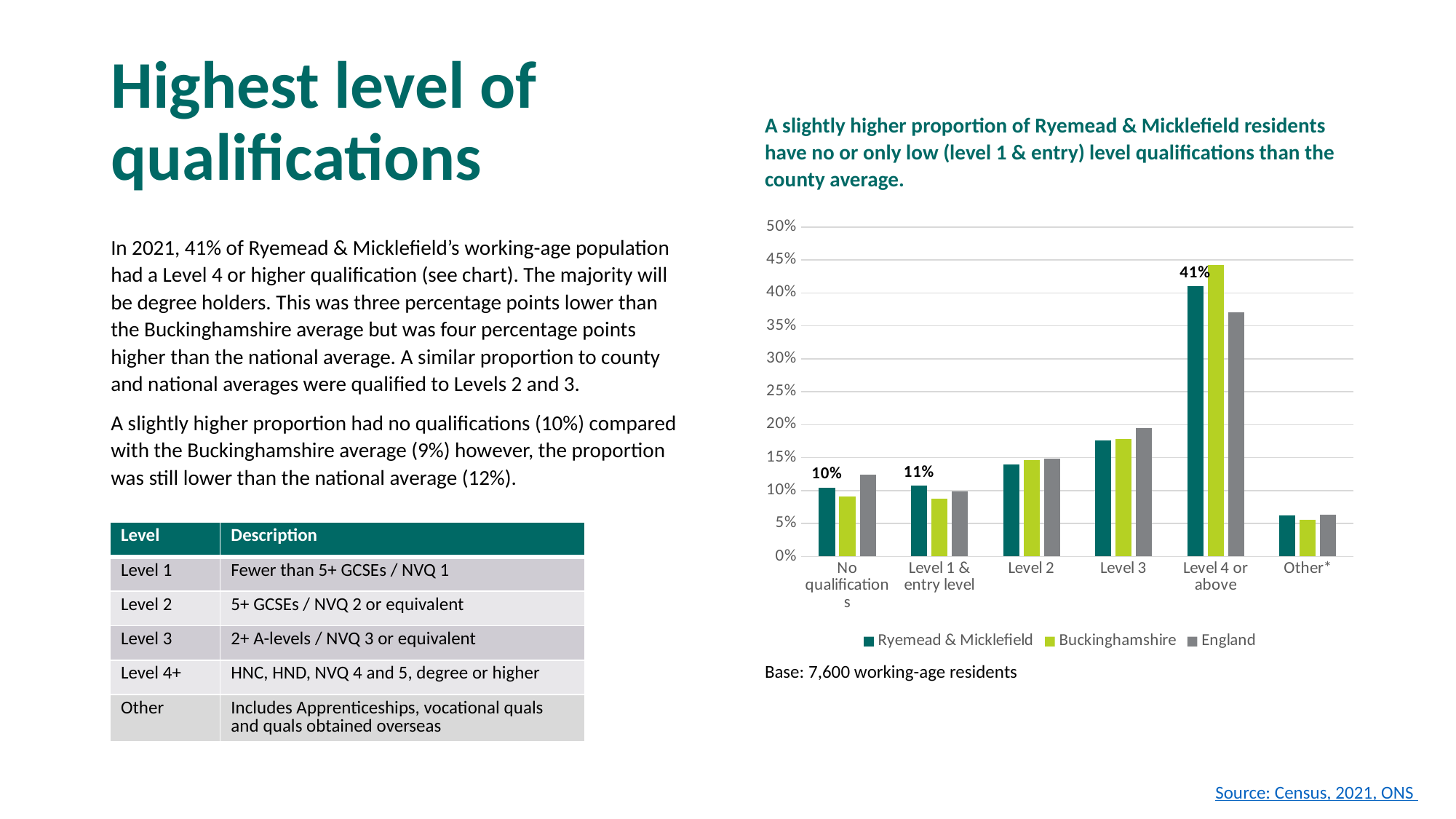
Which category has the highest value for Ryemead & Micklefield? Level 4 or above What is the difference between the Ryemead & Micklefield values for Level 4 or above and No qualifications? 31 percentage points In the Level 4 or above category, which is larger: Buckinghamshire or England? Buckinghamshire Which category has the lowest value for Ryemead & Micklefield? Other* Is the value for England in the No qualifications category greater or less than 10%? greater Is the value for England in the Level 4 or above category greater or less than 35%? greater What type of chart is shown on the slide? Bar chart How many series does the chart's legend list? 3 What is the value for Ryemead & Micklefield in the No qualifications category? 10% What is the value for Ryemead & Micklefield in the Level 1 & entry level category? 11% How many qualification categories are shown on the x axis of the chart? 6 What is the value for Ryemead & Micklefield in the Level 4 or above category? 41%